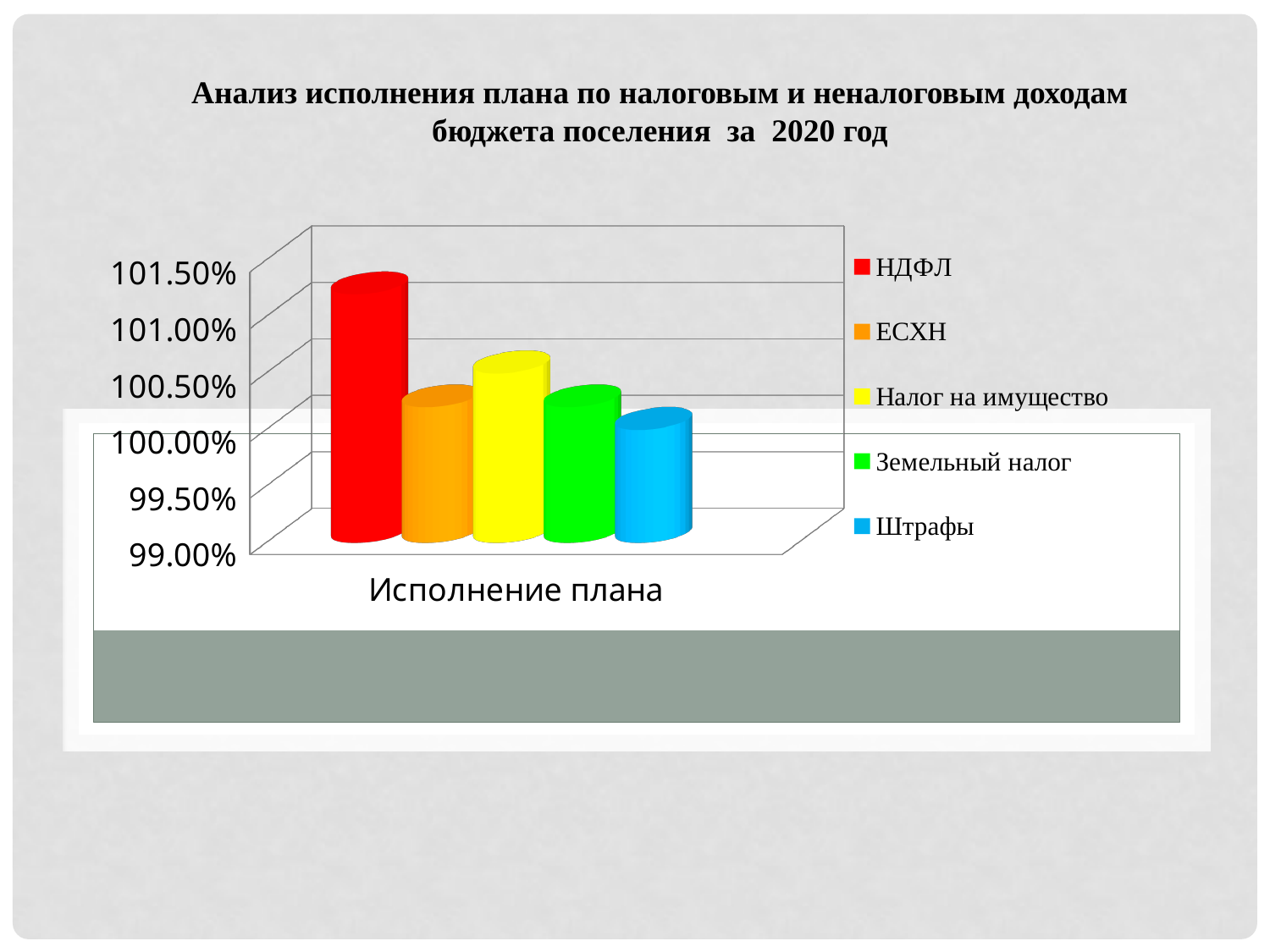
Which series has the lowest value? Штрафы What is the label of the category on the x axis? Исполнение плана Which is larger, the value for Налог на имущество or the value for ЕСХН? Налог на имущество Which is larger, the value for НДФЛ or the value for Штрафы? НДФЛ Is the value for Штрафы greater or less than 101.00%? less Is the value for ЕСХН greater or less than 101.00%? less How many categories are shown on the x axis? 1 Which colour represents Земельный налог in the legend? green How many series does the legend list? 5 What kind of chart is shown on the slide? bar chart Which series has the highest value? НДФЛ Is the value for НДФЛ greater or less than 101.00%? greater